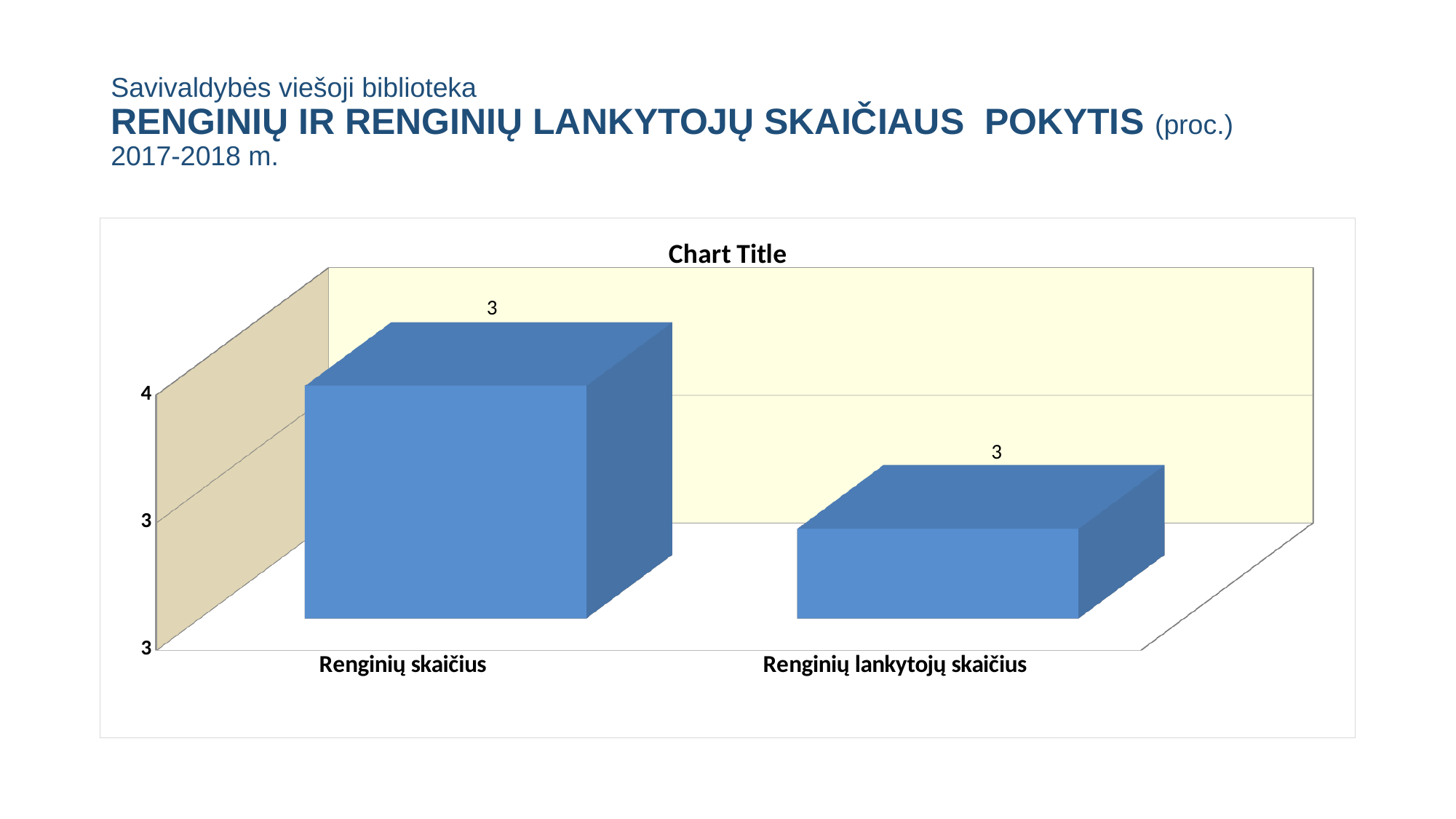
Is the value for Renginių lankytojų skaičius greater or less than 4? less How many categories are plotted on the chart? 2 Which category is shown on the left of the x axis? Renginių skaičius What title is displayed above the chart? Chart Title Is the value for Renginių skaičius greater or less than 4? less What is the value shown for Renginių lankytojų skaičius? 3 What kind of chart is shown on the slide? Bar chart What colour are the bars in the chart? Blue What is the value shown for Renginių skaičius? 3 What is the difference between the labelled values for Renginių skaičius and Renginių lankytojų skaičius? 0